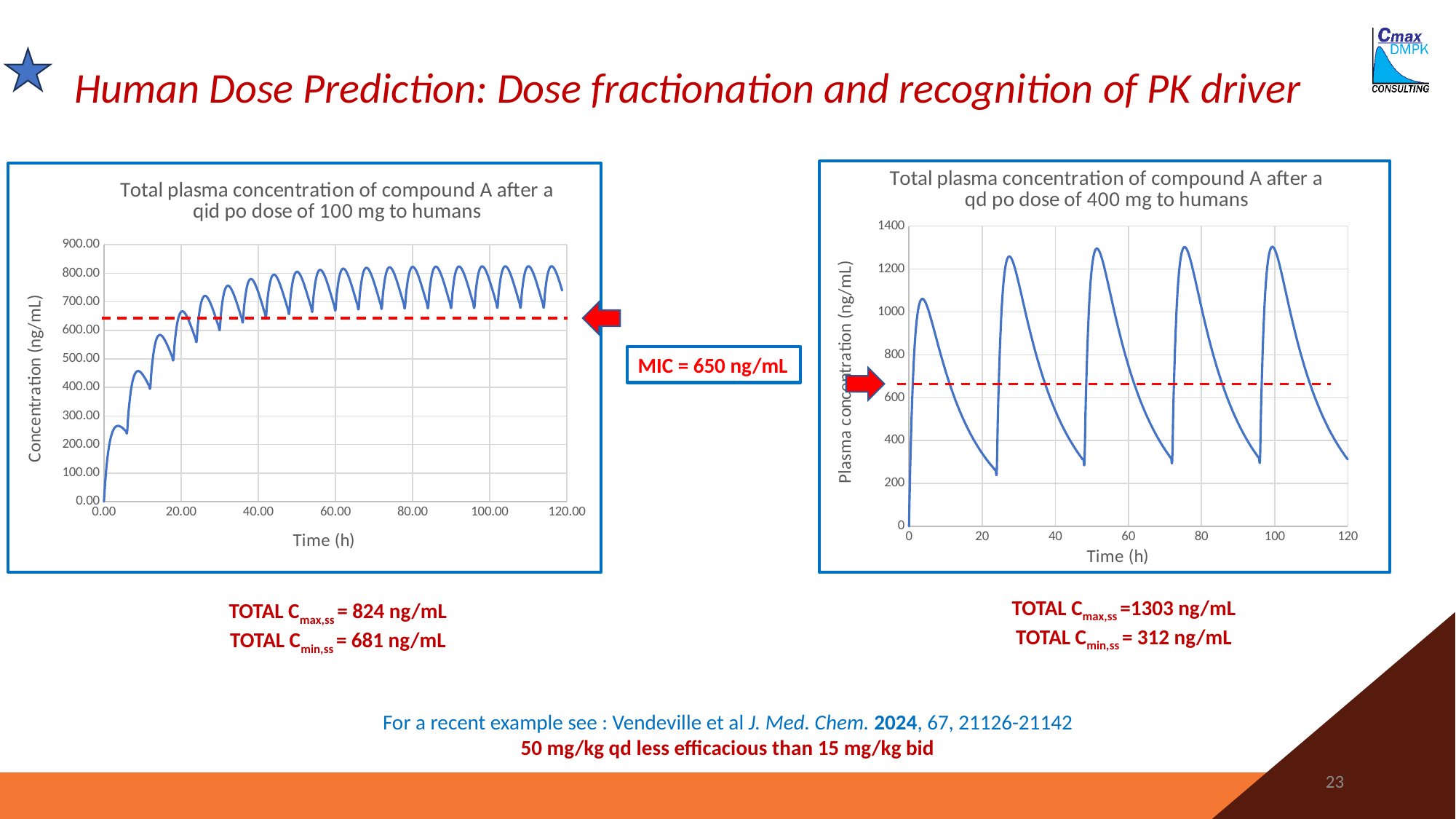
For the left chart (qid po dose of 100 mg), what is the TOTAL Cmax,ss value stated below the chart? 824 ng/mL For the left chart (qid po dose of 100 mg), what is the TOTAL Cmin,ss value stated below the chart? 681 ng/mL In the right chart (qd po dose of 400 mg), are the steady-state trough concentrations greater or less than 600 ng/mL? less In the left chart (qid po dose of 100 mg), does the plasma concentration rise or fall over the first 40 hours? rise For the right chart (qd po dose of 400 mg), what is the difference between the stated TOTAL Cmax,ss and TOTAL Cmin,ss? 991 ng/mL What MIC value does the red dashed line on both charts represent, according to the label between the charts? 650 ng/mL For the right chart (qd po dose of 400 mg), what is the TOTAL Cmax,ss value stated below the chart? 1303 ng/mL In the left chart (qid po dose of 100 mg), are the steady-state trough concentrations greater or less than 600 ng/mL? greater What kind of chart is the left chart, 'Total plasma concentration of compound A after a qid po dose of 100 mg to humans'? line chart Which dosing regimen has the higher stated TOTAL Cmax,ss: the qid 100 mg dose (left chart) or the qd 400 mg dose (right chart)? qd 400 mg dose (right chart) For the left chart (qid po dose of 100 mg), what is the difference between the stated TOTAL Cmax,ss and TOTAL Cmin,ss? 143 ng/mL For the right chart (qd po dose of 400 mg), what is the TOTAL Cmin,ss value stated below the chart? 312 ng/mL